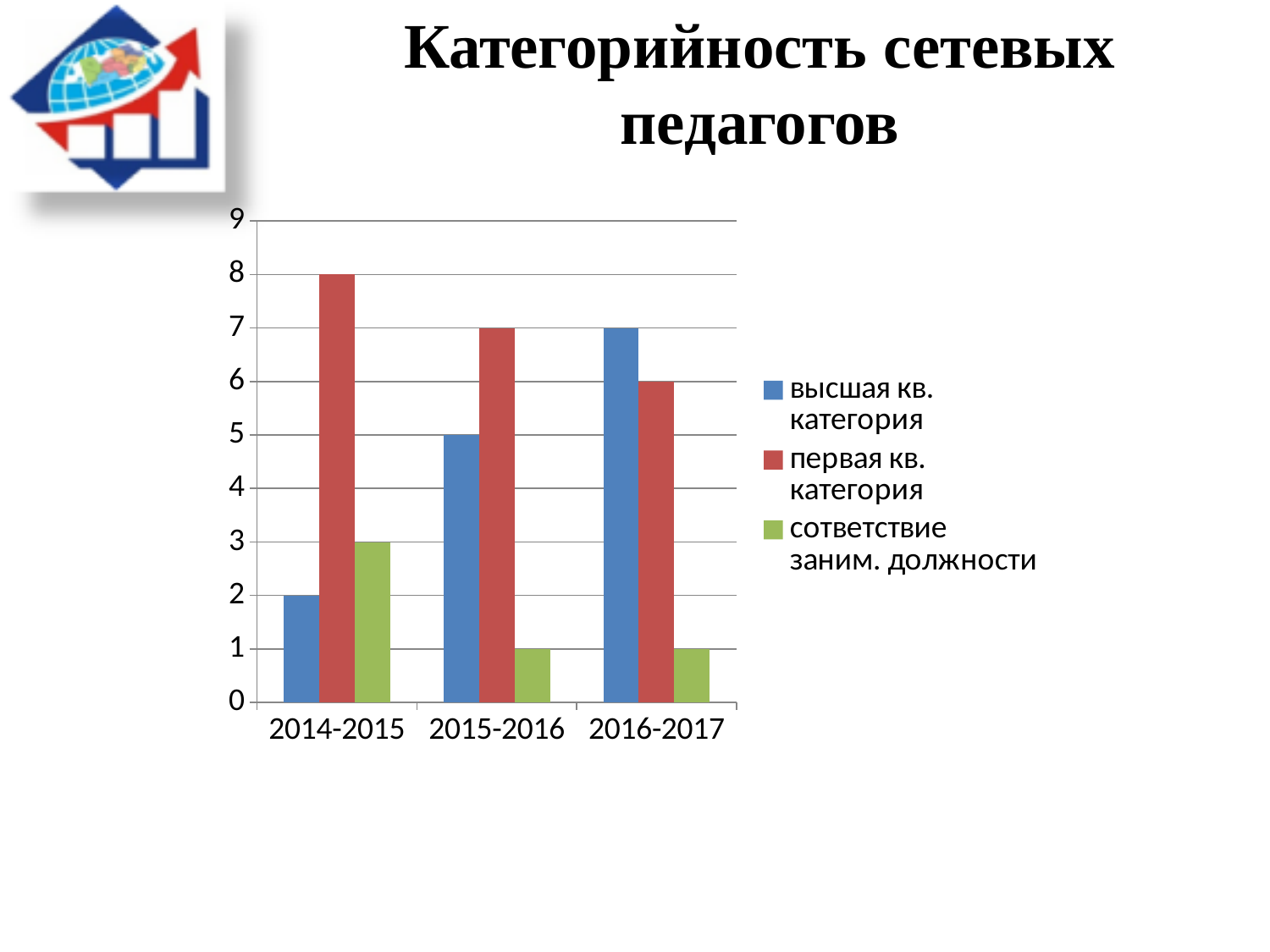
How many series does the legend list? 3 What kind of chart is shown on the slide? bar chart What is the value for 'сответствие заним. должности' in 2014-2015? 3 In which year is 'высшая кв. категория' highest? 2016-2017 What is the difference between 'первая кв. категория' and 'высшая кв. категория' in 2014-2015? 6 Does 'высшая кв. категория' rise or fall from 2014-2015 to 2016-2017? rise What is the value for 'первая кв. категория' in 2014-2015? 8 How many year categories are shown on the x axis? 3 What is the title of the chart on the slide? Категорийность сетевых педагогов In which year is 'первая кв. категория' lowest? 2016-2017 What is the value for 'высшая кв. категория' in 2016-2017? 7 Which is larger in 2016-2017: 'высшая кв. категория' or 'первая кв. категория'? высшая кв. категория